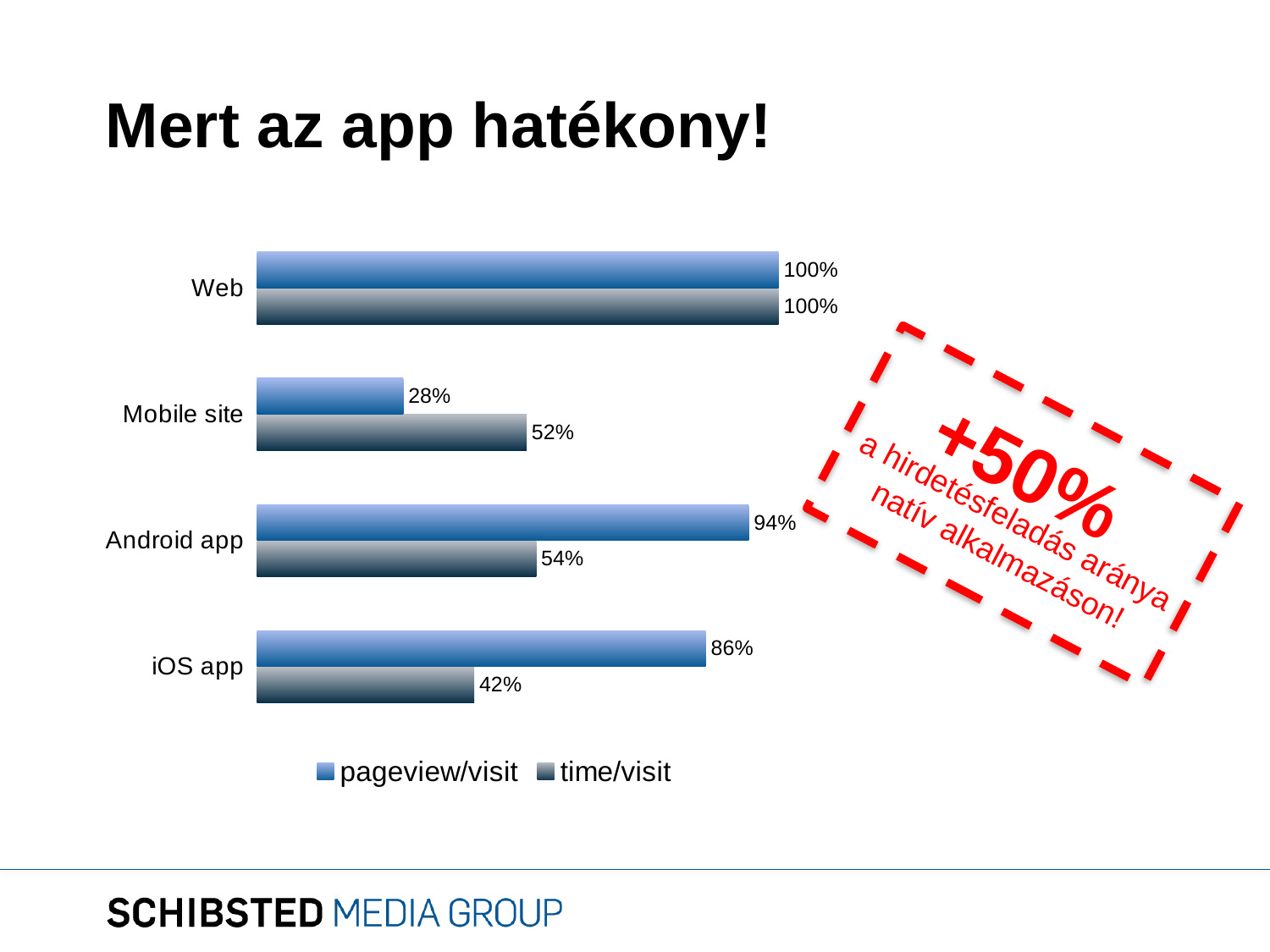
What is the difference between the pageview/visit values for Android app and iOS app? 8% What is the difference between the pageview/visit and time/visit values for Android app? 40% How many series does the legend list? 2 What is the time/visit value for iOS app? 42% Which is larger: the time/visit value for Mobile site or the time/visit value for iOS app? Mobile site What is the time/visit value for Mobile site? 52% What is the pageview/visit value for Android app? 94% What kind of chart is shown on the slide? Bar chart Which category has the lowest pageview/visit value? Mobile site Which category has the highest time/visit value? Web What is the pageview/visit value for Web? 100% How many categories are shown on the chart? 4